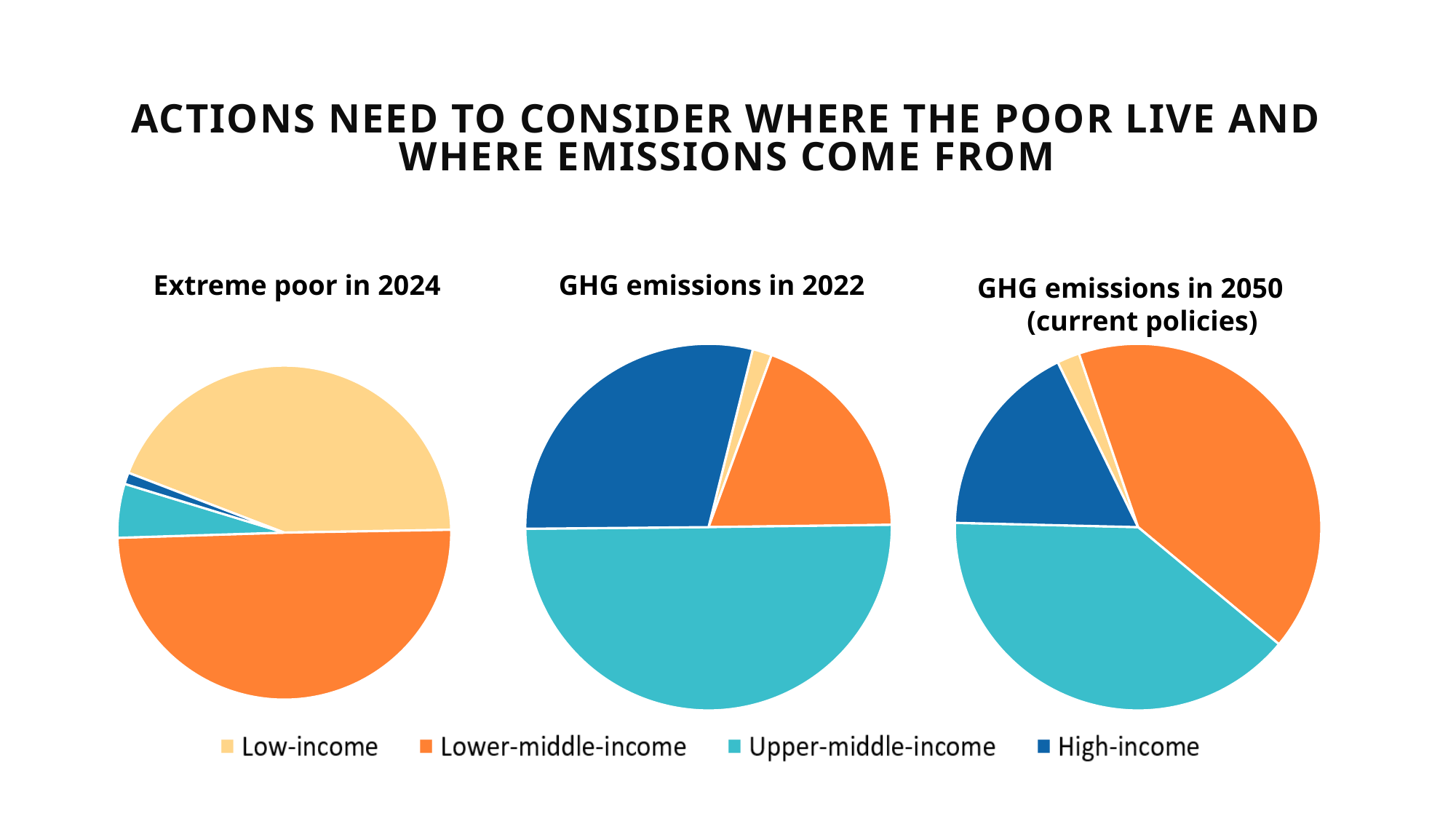
In the 'GHG emissions in 2022' pie chart, which income group has the smallest slice? Low-income How many pie charts are on the slide? 3 In the 'GHG emissions in 2022' pie chart, which income group has the largest slice? Upper-middle-income In the 'GHG emissions in 2050 (current policies)' pie chart, which income group has the largest slice? Lower-middle-income Which colour represents High-income in the legend? Dark blue In the 'Extreme poor in 2024' pie chart, which slice is larger: Low-income or Upper-middle-income? Low-income In the 'GHG emissions in 2050 (current policies)' pie chart, which slice is larger: Upper-middle-income or High-income? Upper-middle-income In the 'GHG emissions in 2050 (current policies)' pie chart, which income group has the smallest slice? Low-income How many categories does the legend list? 4 In the 'Extreme poor in 2024' pie chart, which income group has the largest slice? Lower-middle-income What kind of charts are shown on the slide? Pie charts In the 'Extreme poor in 2024' pie chart, which income group has the smallest slice? High-income